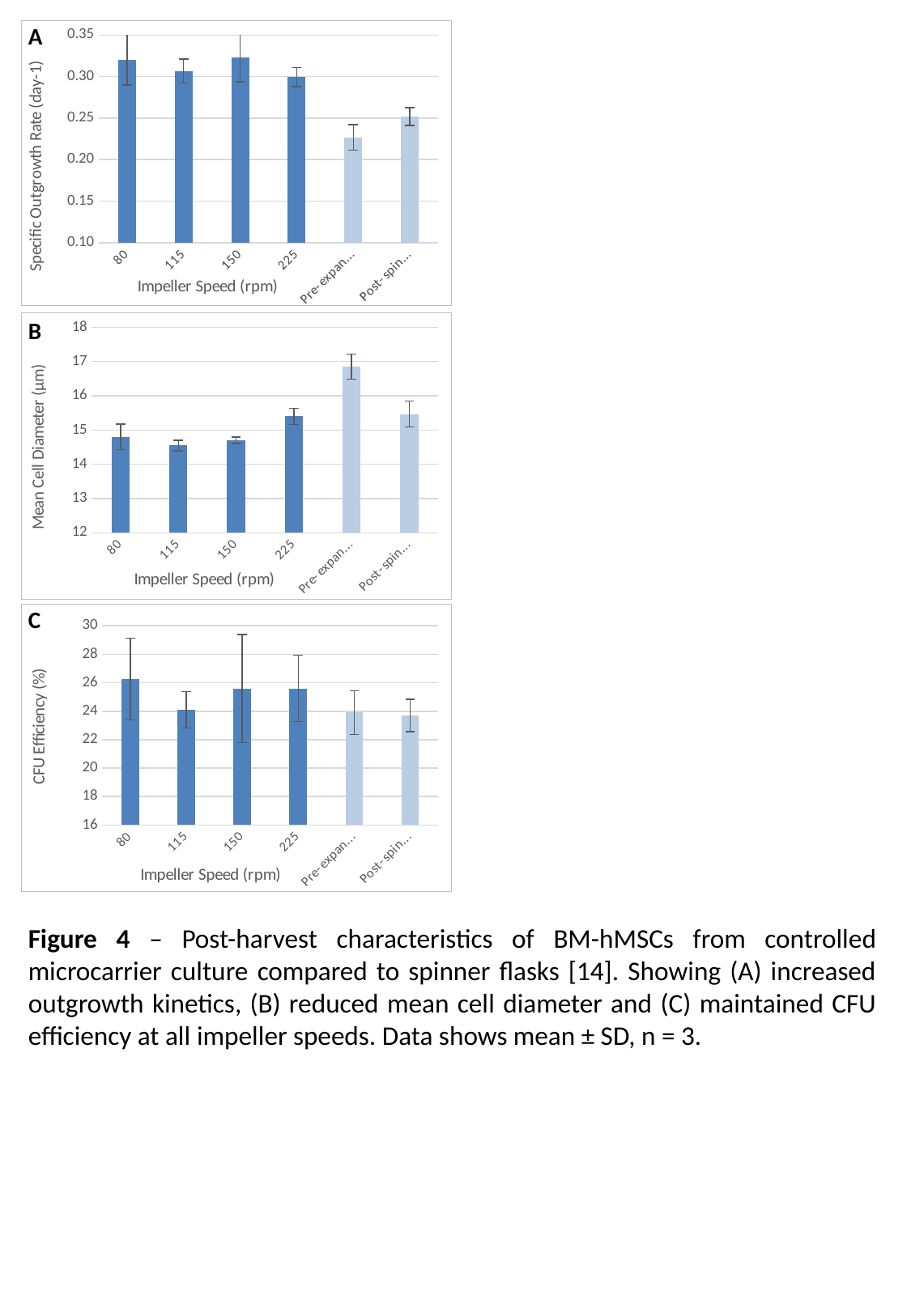
In chart A, is the value for the fifth bar (Pre-expan...) greater or less than 0.25? less In chart B, which is larger, the value for 225 rpm or the value for 80 rpm? 225 In chart B, is the value for 225 rpm greater or less than 15? greater In chart B, which category has the highest mean cell diameter? Pre-expan... In chart C, which category has the highest CFU efficiency? 80 What is the y-axis title of chart C? CFU Efficiency (%) In chart C, which is larger, the value for 80 rpm or the value for 115 rpm? 80 What type of chart is chart A? bar chart In chart B, is the value for 80 rpm greater or less than 15? less How many bars are plotted in chart B? 6